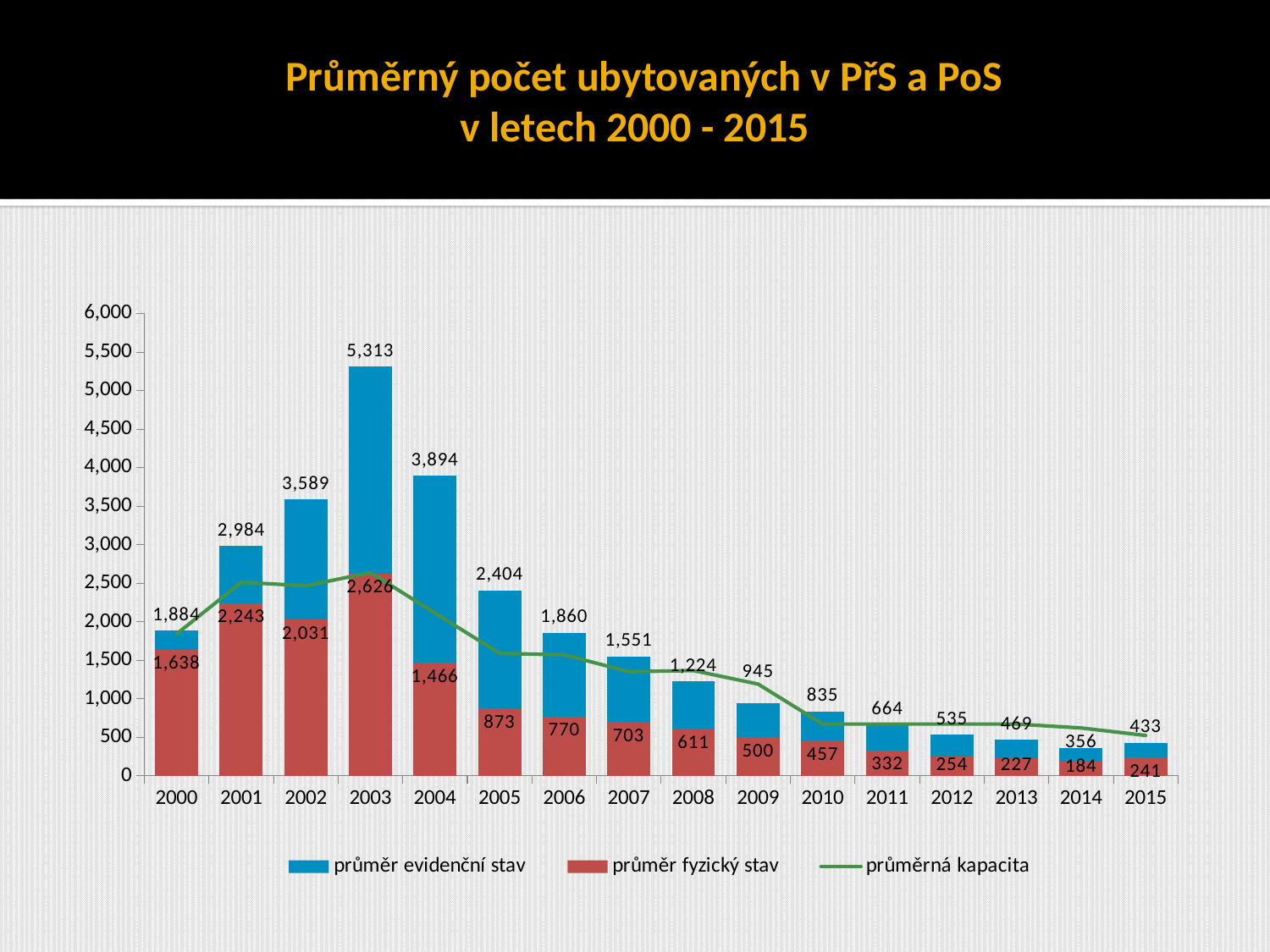
What is the difference between průměr evidenční stav and průměr fyzický stav in 2003? 2,687 How many series does the legend list? 3 What is the value of průměr evidenční stav for 2003? 5,313 What is the value of průměr evidenční stav for 2009? 945 In which year is průměr fyzický stav lowest? 2014 Which year has the larger průměr fyzický stav, 2001 or 2002? 2001 What is the value of průměr fyzický stav for 2004? 1,466 Does průměr evidenční stav rise or fall from 2003 to 2015? fall By how much did průměr evidenční stav increase from 2000 to 2001? 1,100 In which year is průměr evidenční stav highest? 2003 How many years are shown on the x axis? 16 Is the value of průměrná kapacita for 2010 greater or less than 500? greater